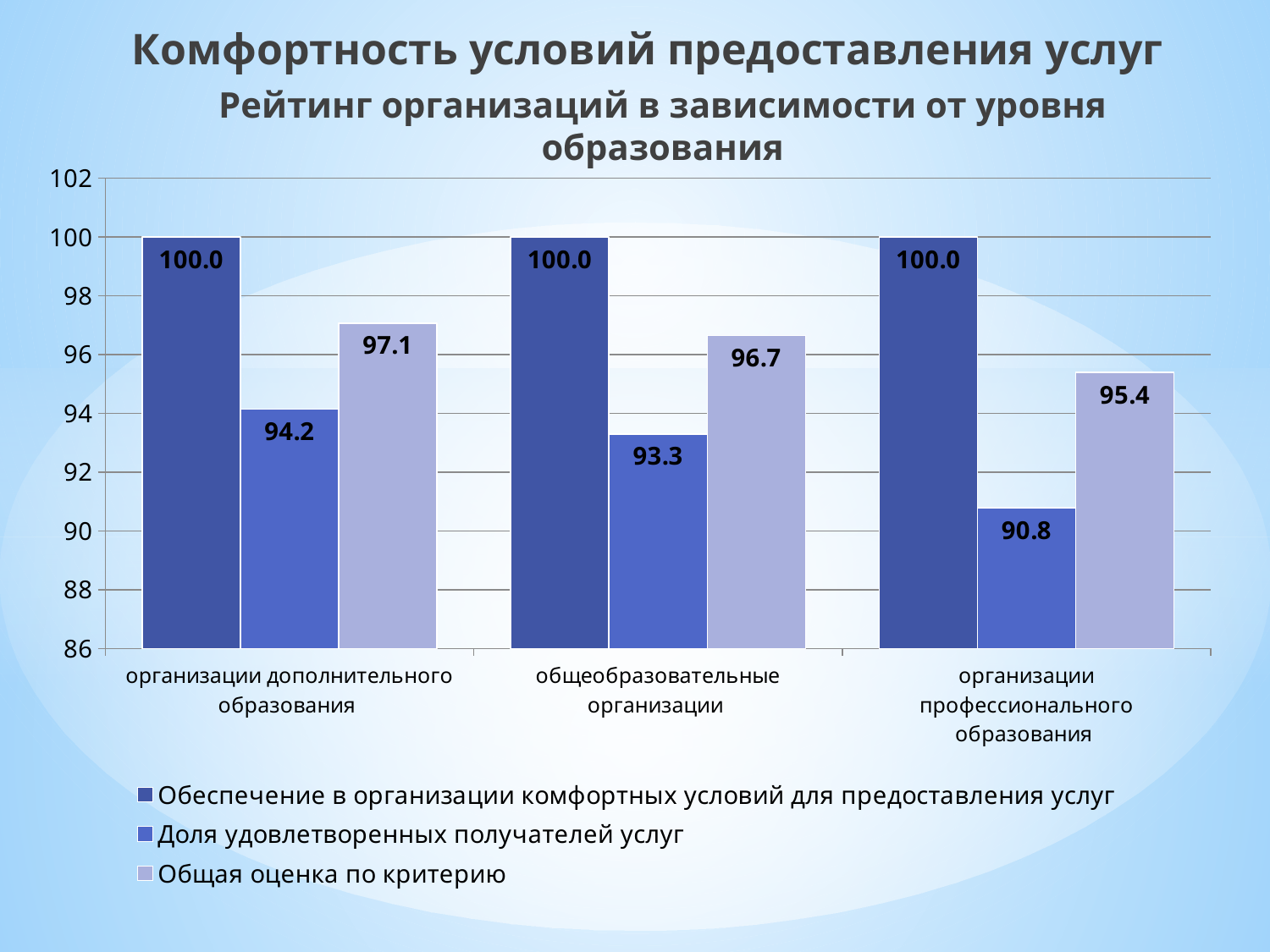
How many series does the legend list? 3 Which category has the highest value for "Общая оценка по критерию"? организации дополнительного образования What kind of chart is shown on the slide? bar chart Is the value of "Доля удовлетворенных получателей услуг" for "организации профессионального образования" greater or less than 92? less What is the value of "Общая оценка по критерию" for "общеобразовательные организации"? 96.7 What is the value of "Обеспечение в организации комфортных условий для предоставления услуг" for "организации профессионального образования"? 100.0 Which category has the lowest value for "Доля удовлетворенных получателей услуг"? организации профессионального образования Does the value of "Общая оценка по критерию" rise or fall across the categories from left to right? fall How many categories are shown on the x axis? 3 Which is larger: "Доля удовлетворенных получателей услуг" for "организации дополнительного образования" or for "общеобразовательные организации"? организации дополнительного образования What is the difference between "Общая оценка по критерию" and "Доля удовлетворенных получателей услуг" for "организации профессионального образования"? 4.6 What is the value of "Доля удовлетворенных получателей услуг" for "организации дополнительного образования"? 94.2